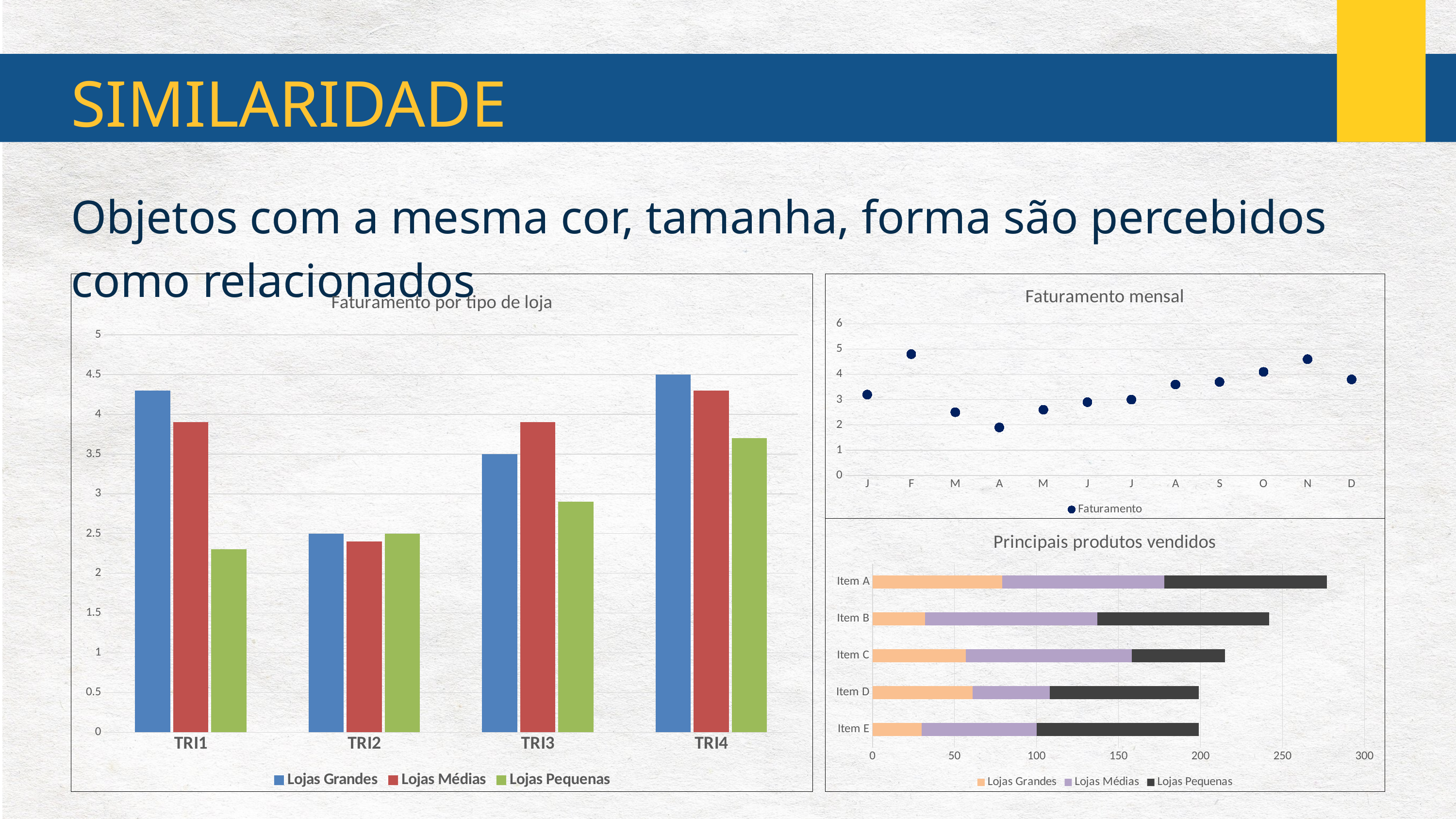
In "Faturamento mensal", is the value for F greater or less than 4? greater In "Principais produtos vendidos", is the Lojas Grandes value for Item A greater or less than 50? greater How many data points are plotted in "Faturamento mensal"? 12 How many categories are shown on the x axis of "Faturamento por tipo de loja"? 4 In "Faturamento mensal", which month has the lowest value? A (April) How many series does the legend of "Faturamento por tipo de loja" list? 3 In "Faturamento por tipo de loja", is the value for Lojas Pequenas in TRI3 greater or less than 3? less What kind of chart is "Faturamento por tipo de loja"? bar chart In "Faturamento por tipo de loja", which is larger in TRI3: Lojas Grandes or Lojas Médias? Lojas Médias In "Principais produtos vendidos", which item has the longest total bar? Item A In "Faturamento por tipo de loja", which quarter has the lowest value for Lojas Grandes? TRI2